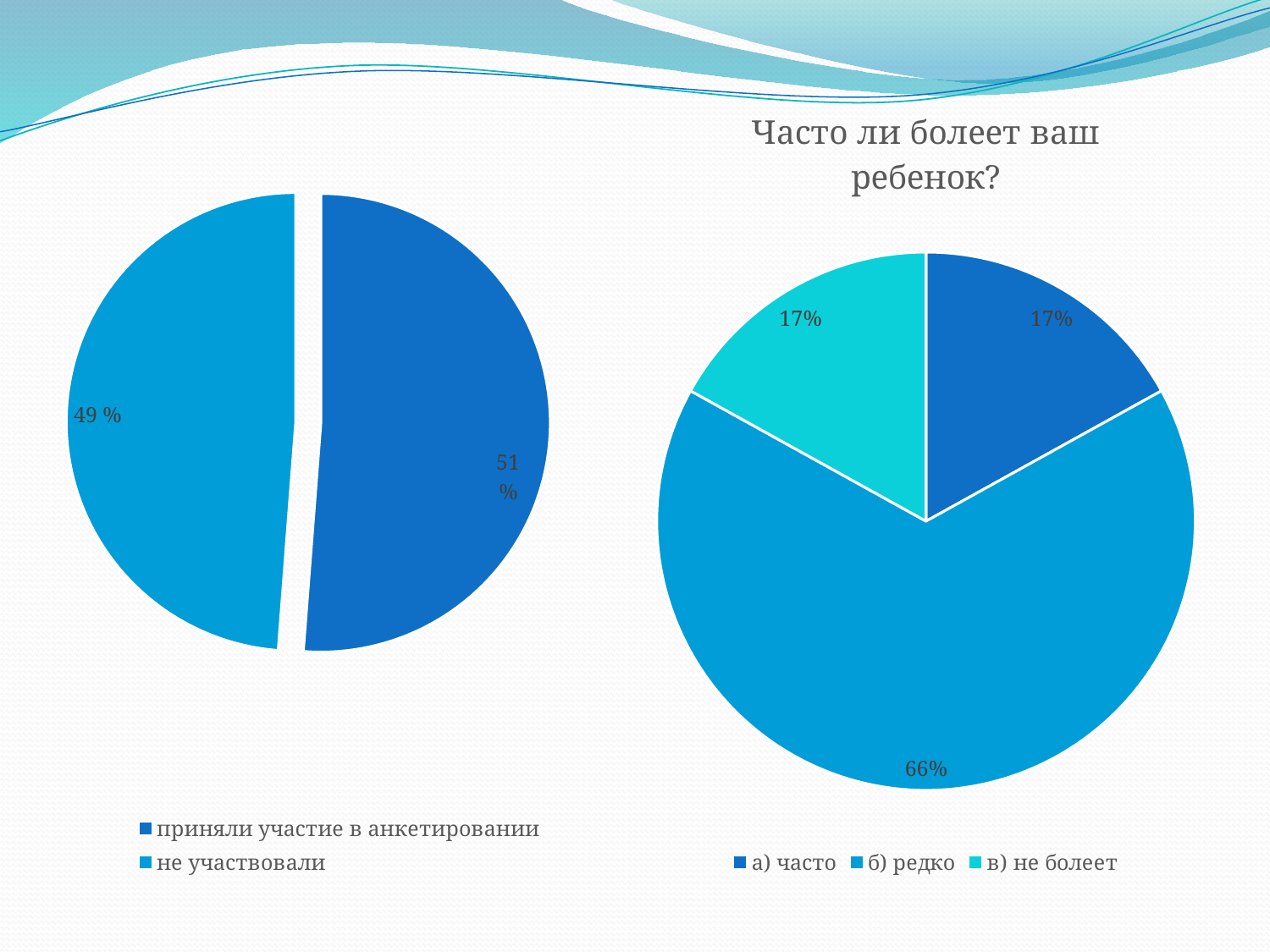
In the chart on the left of the slide, what share is labelled for "приняли участие в анкетировании"? 51 % In the chart on the left of the slide, how many entries does the legend list? 2 In the chart titled "Часто ли болеет ваш ребенок?", what share is labelled for "а) часто"? 17% What is the title of the chart on the right of the slide? Часто ли болеет ваш ребенок? In the chart on the left of the slide, which is larger: the share for "приняли участие в анкетировании" or the share for "не участвовали"? приняли участие в анкетировании What kind of chart is the chart on the left of the slide? pie chart In the chart on the left of the slide, what share is labelled for "не участвовали"? 49 % In the chart titled "Часто ли болеет ваш ребенок?", what is the difference between the share for "б) редко" and the share for "в) не болеет"? 49% In the chart titled "Часто ли болеет ваш ребенок?", how many slices does the pie have? 3 What kind of chart is the chart titled "Часто ли болеет ваш ребенок?"? pie chart In the chart titled "Часто ли болеет ваш ребенок?", what share is labelled for "б) редко"? 66% In the chart titled "Часто ли болеет ваш ребенок?", which category has the largest slice? б) редко